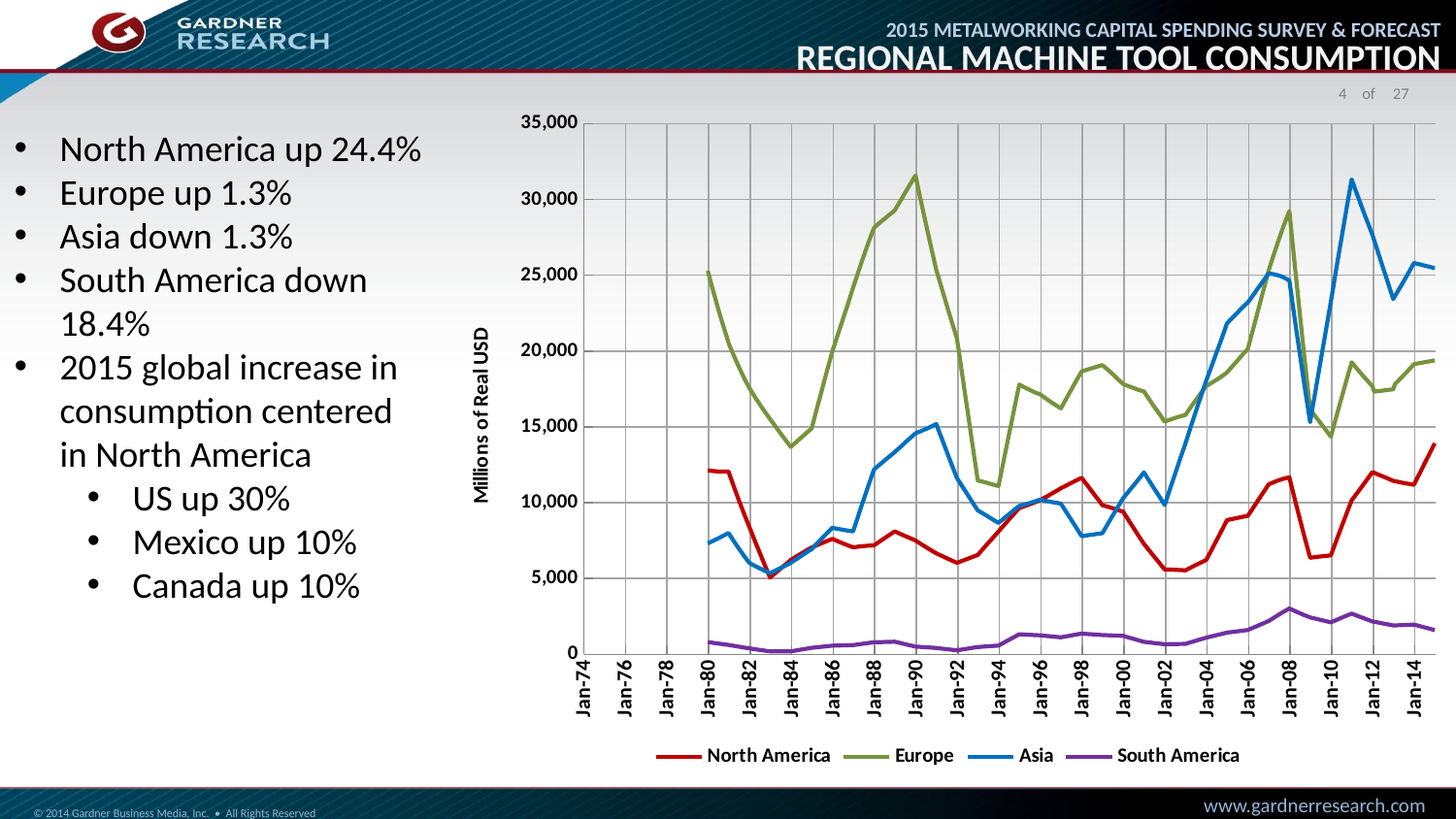
Is the value for Asia at Jan-82 greater or less than 10,000? less Which series has the lowest values across the whole chart? South America How many series does the chart legend list? 4 At Jan-14, which is larger: Asia or North America? Asia What is the label on the vertical axis of the chart? Millions of Real USD Does the Asia series rise or fall between Jan-02 and Jan-06? rise Is the value for North America at Jan-14 greater or less than 10,000? greater At Jan-90, which is larger: Europe or Asia? Europe Is the value for Europe at Jan-84 greater or less than 15,000? less What are the series names listed in the chart legend? North America, Europe, Asia, South America What kind of chart is shown on the slide? line chart